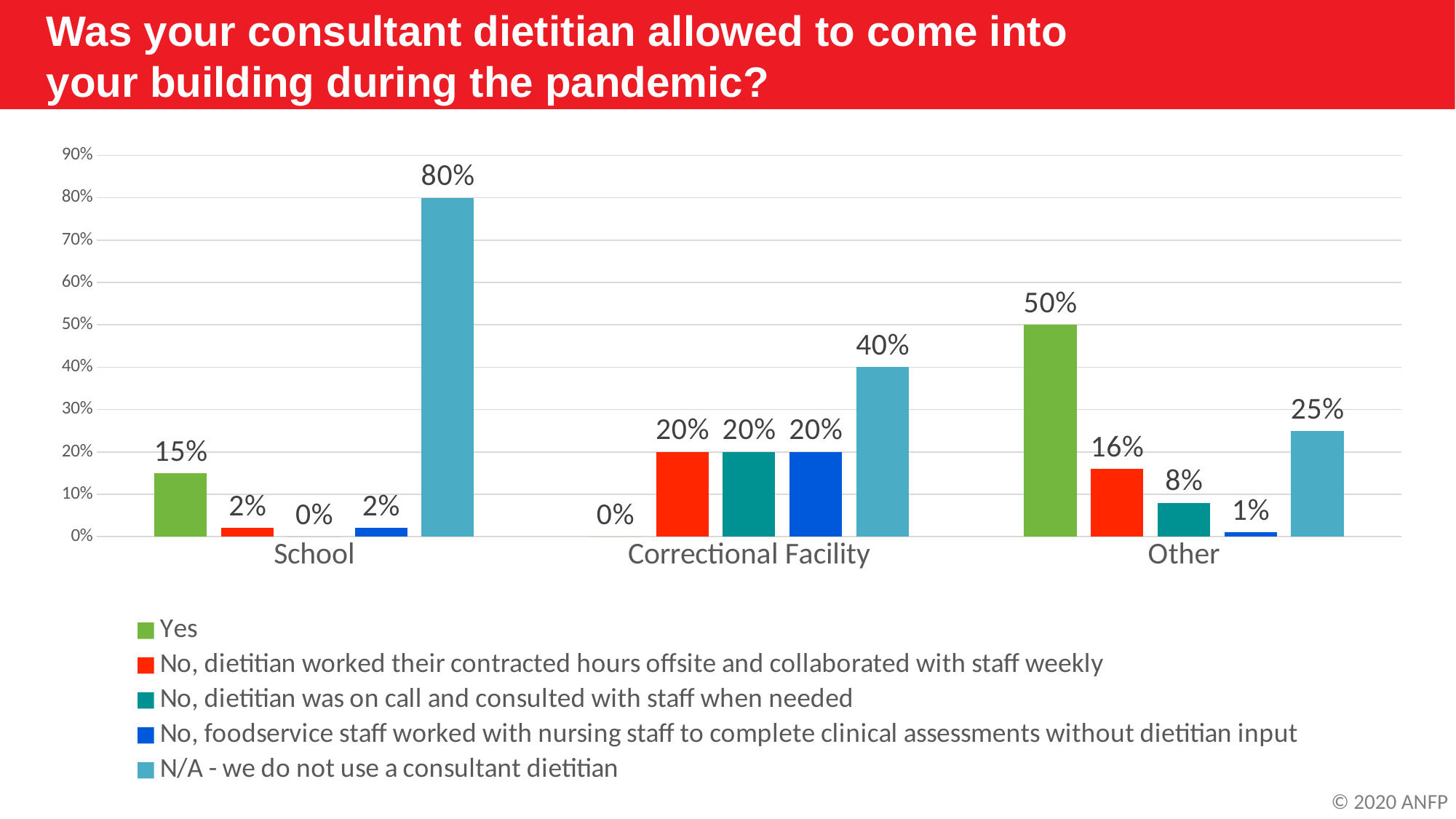
What is the difference between the "N/A - we do not use a consultant dietitian" values for School and Correctional Facility? 40% What percentage of Other respondents answered "No, dietitian was on call and consulted with staff when needed"? 8% What kind of chart is shown on the slide? Bar chart Which category has the lowest value for "N/A - we do not use a consultant dietitian"? Other What is the value for "Yes" in the Correctional Facility category? 0% How many categories are shown on the x axis? 3 Which category has the highest value for "Yes"? Other Which is larger: the "Yes" value for Other or the "N/A - we do not use a consultant dietitian" value for Other? Yes (50%) What percentage of School respondents answered "Yes"? 15% What is the value for "N/A - we do not use a consultant dietitian" in the School category? 80% Which colour represents the "Yes" series in the legend? Green How many series does the legend list? 5